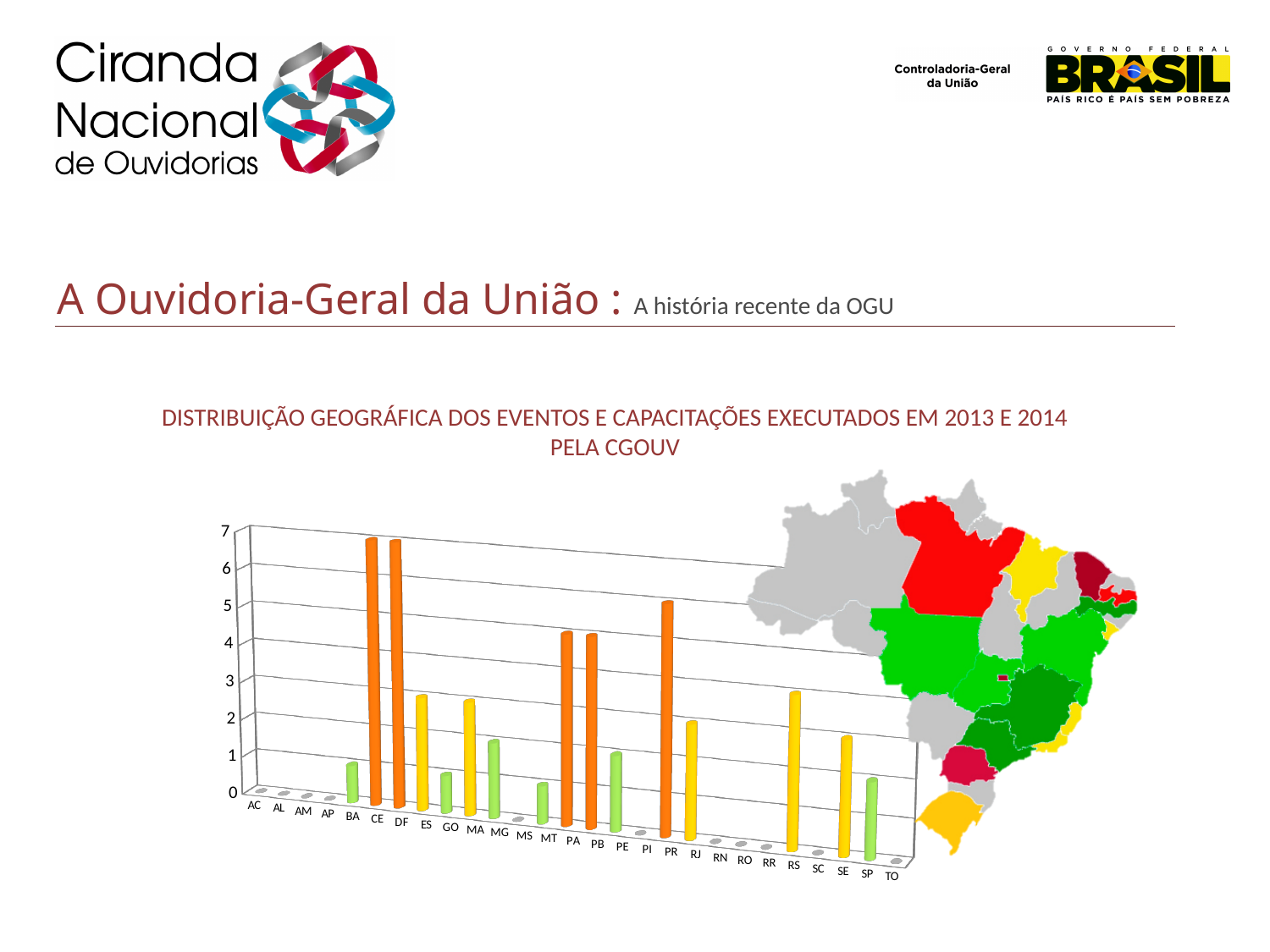
What kind of chart is shown on the slide? bar chart Is the value for PR greater or less than 4? greater Is the value for CE greater or less than 5? greater What is the title of the chart? DISTRIBUIÇÃO GEOGRÁFICA DOS EVENTOS E CAPACITAÇÕES EXECUTADOS EM 2013 E 2014 PELA CGOUV How many state categories are shown on the x axis of the chart? 27 Is the value for BA greater or less than 2? less Which has the larger value, CE or BA? CE Which has the larger value, PR or RJ? PR Which has the larger value, PA or GO? PA